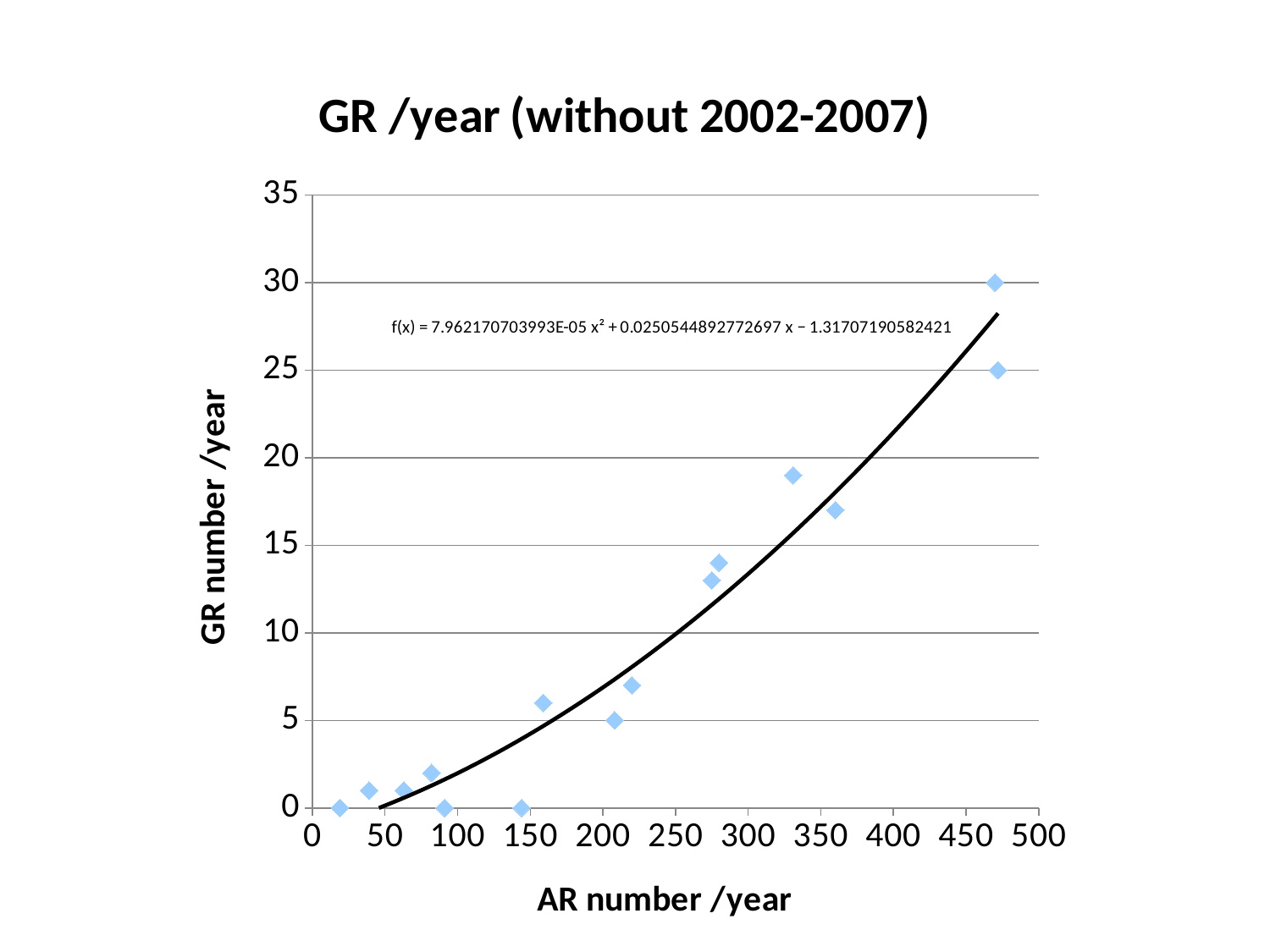
Is the GR number /year value for the point at about 210 AR number /year greater or less than 10? less What kind of chart is shown on the slide? scatter chart What is the label of the vertical axis? GR number /year What is the lowest GR number /year value plotted on the chart? 0 Are the GR number /year values for the points near 470 AR number /year greater or less than 20? greater Is the GR number /year value for the point at about 145 AR number /year greater or less than 5? less What is the highest GR number /year value plotted on the chart? 30 How many data points are plotted on the chart? 15 Do the GR number /year values generally rise or fall as AR number /year increases? rise Which has the larger GR number /year value: the point at about 330 AR number /year or the point at about 360 AR number /year? the point at about 330 AR number /year What is the title of the chart? GR /year (without 2002-2007)